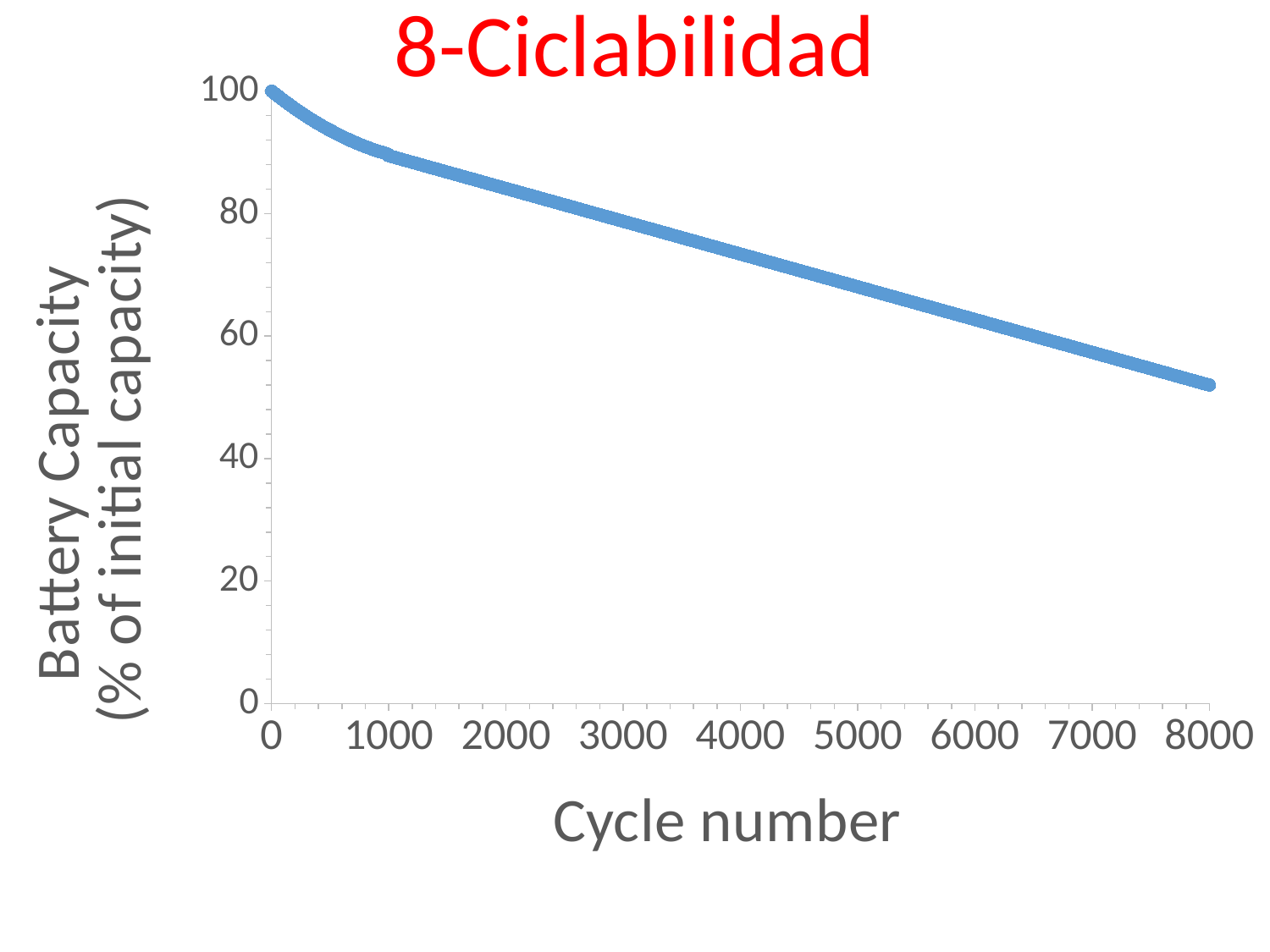
Is the battery capacity at cycle number 8000 greater or less than 60? less What is the label of the x axis? Cycle number At which cycle number shown on the x axis is the battery capacity lowest? 8000 Is the battery capacity at cycle number 6000 greater or less than 80? less What kind of chart is shown on the slide? line chart Is the battery capacity at cycle number 8000 greater or less than 40? greater Does battery capacity rise or fall as the cycle number increases? fall What is the title of the chart? 8-Ciclabilidad Which has the higher battery capacity: cycle number 2000 or cycle number 6000? cycle number 2000 What is the battery capacity at cycle number 0? 100